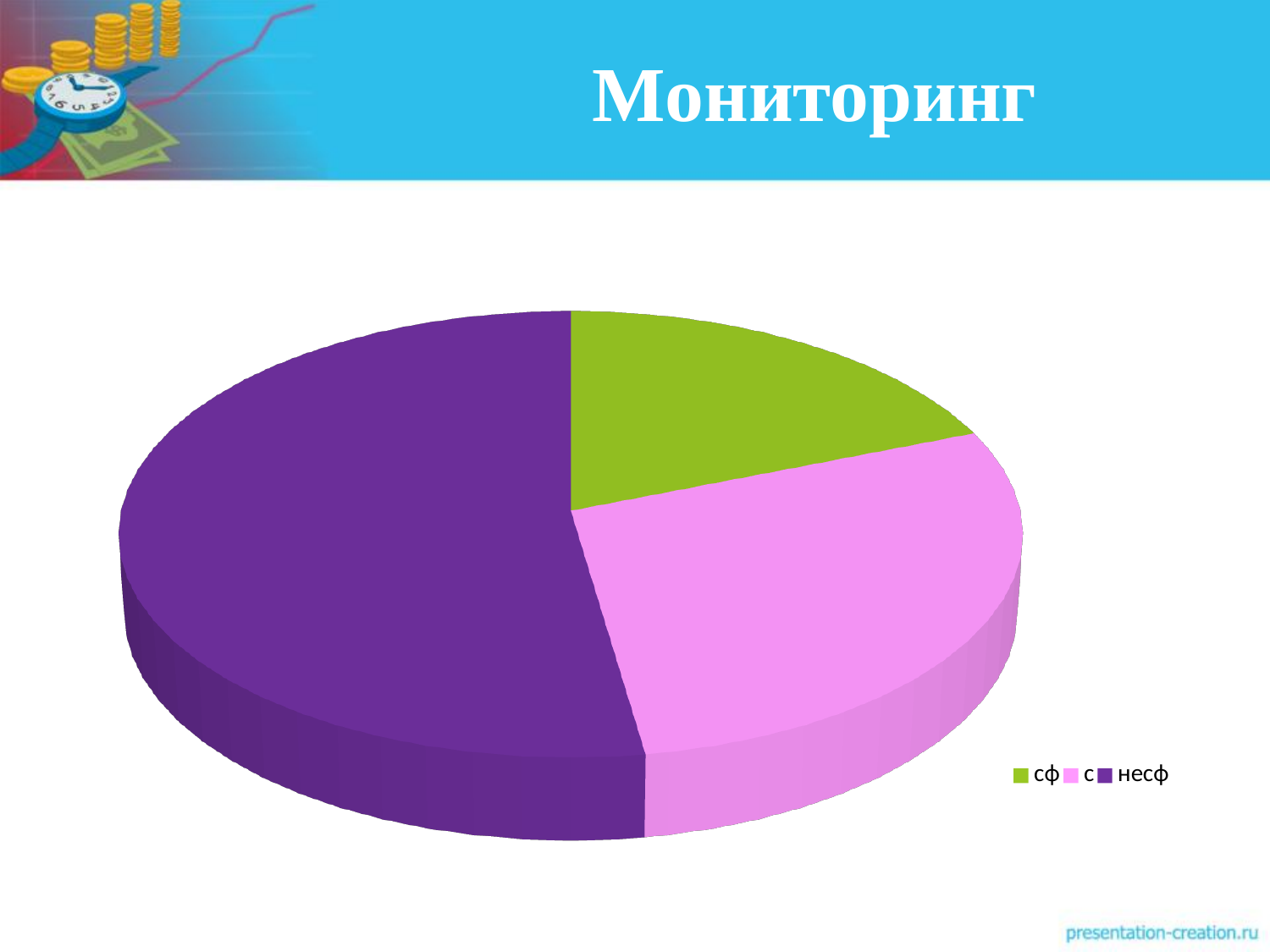
How many entries does the legend list? 3 What kind of chart is shown on the slide? pie chart What is the title shown at the top of the slide? Мониторинг Which category has the largest slice of the pie? несф How many slices does the pie chart have? 3 Which slice is larger, несф or с? несф Which slice is larger, с or сф? с Which category has the smallest slice of the pie? сф Does the несф slice take up more or less than half of the pie? more What colour is the несф slice? purple Which slice is smaller, сф or несф? сф